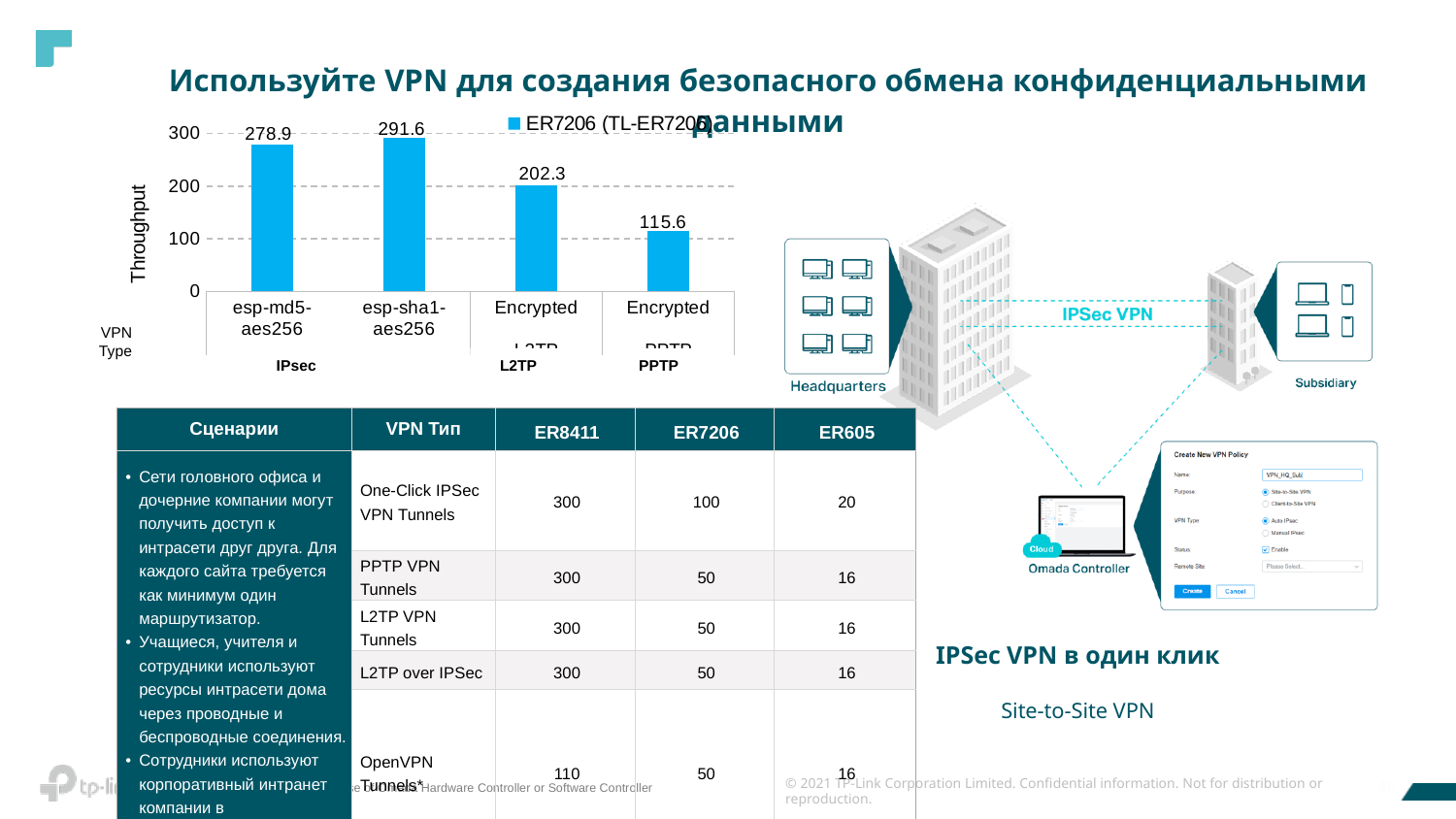
Which VPN type has the highest throughput in the chart? esp-sha1-aes256 What is the throughput value for esp-md5-aes256? 278.9 What type of chart is shown on the slide? bar chart What is the difference in throughput between esp-sha1-aes256 and esp-md5-aes256? 12.7 Which has a higher throughput, Encrypted L2TP or Encrypted PPTP? Encrypted L2TP How many bars are plotted in the chart? 4 Which VPN type has the lowest throughput in the chart? Encrypted PPTP What is the throughput value for Encrypted PPTP? 115.6 What is the throughput value for Encrypted L2TP? 202.3 What series does the chart legend list? ER7206 (TL-ER7206) What is the throughput value for esp-sha1-aes256? 291.6 What is the difference in throughput between Encrypted L2TP and Encrypted PPTP? 86.7